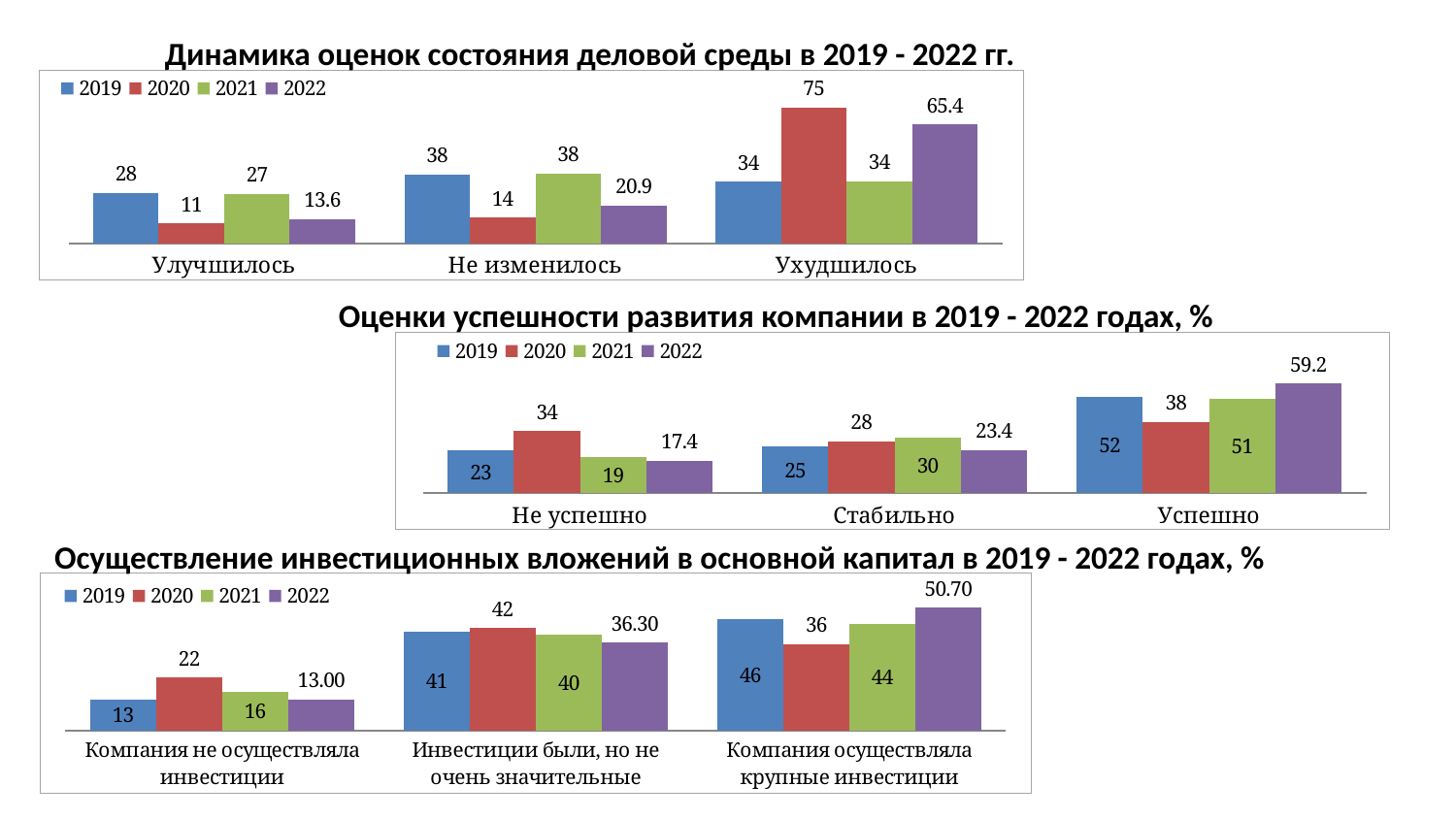
In the chart 'Оценки успешности развития компании в 2019 - 2022 годах, %', which is larger in the 'Стабильно' category: the value for 2021 or the value for 2022? 2021 In the chart 'Оценки успешности развития компании в 2019 - 2022 годах, %', which year has the lowest value in the 'Не успешно' category? 2022 In the chart 'Осуществление инвестиционных вложений в основной капитал в 2019 - 2022 годах, %', what is the value for 2022 in the 'Компания осуществляла крупные инвестиции' category? 50.70 In the chart 'Динамика оценок состояния деловой среды в 2019 - 2022 гг.', what is the value for 2022 in the 'Улучшилось' category? 13.6 How many categories are shown on the x axis of the chart 'Оценки успешности развития компании в 2019 - 2022 годах, %'? 3 In the chart 'Динамика оценок состояния деловой среды в 2019 - 2022 гг.', what is the difference between the 2019 and 2020 values in the 'Не изменилось' category? 24 How many series does the legend list in the chart 'Динамика оценок состояния деловой среды в 2019 - 2022 гг.'? 4 In the chart 'Осуществление инвестиционных вложений в основной капитал в 2019 - 2022 годах, %', what is the difference between the 2020 and 2019 values in the 'Компания не осуществляла инвестиции' category? 9 In the chart 'Динамика оценок состояния деловой среды в 2019 - 2022 гг.', what is the value for 2020 in the 'Ухудшилось' category? 75 In the chart 'Динамика оценок состояния деловой среды в 2019 - 2022 гг.', which year has the highest value in the 'Ухудшилось' category? 2020 What type of chart is 'Осуществление инвестиционных вложений в основной капитал в 2019 - 2022 годах, %'? Bar chart In the chart 'Оценки успешности развития компании в 2019 - 2022 годах, %', what is the value for 2022 in the 'Успешно' category? 59.2